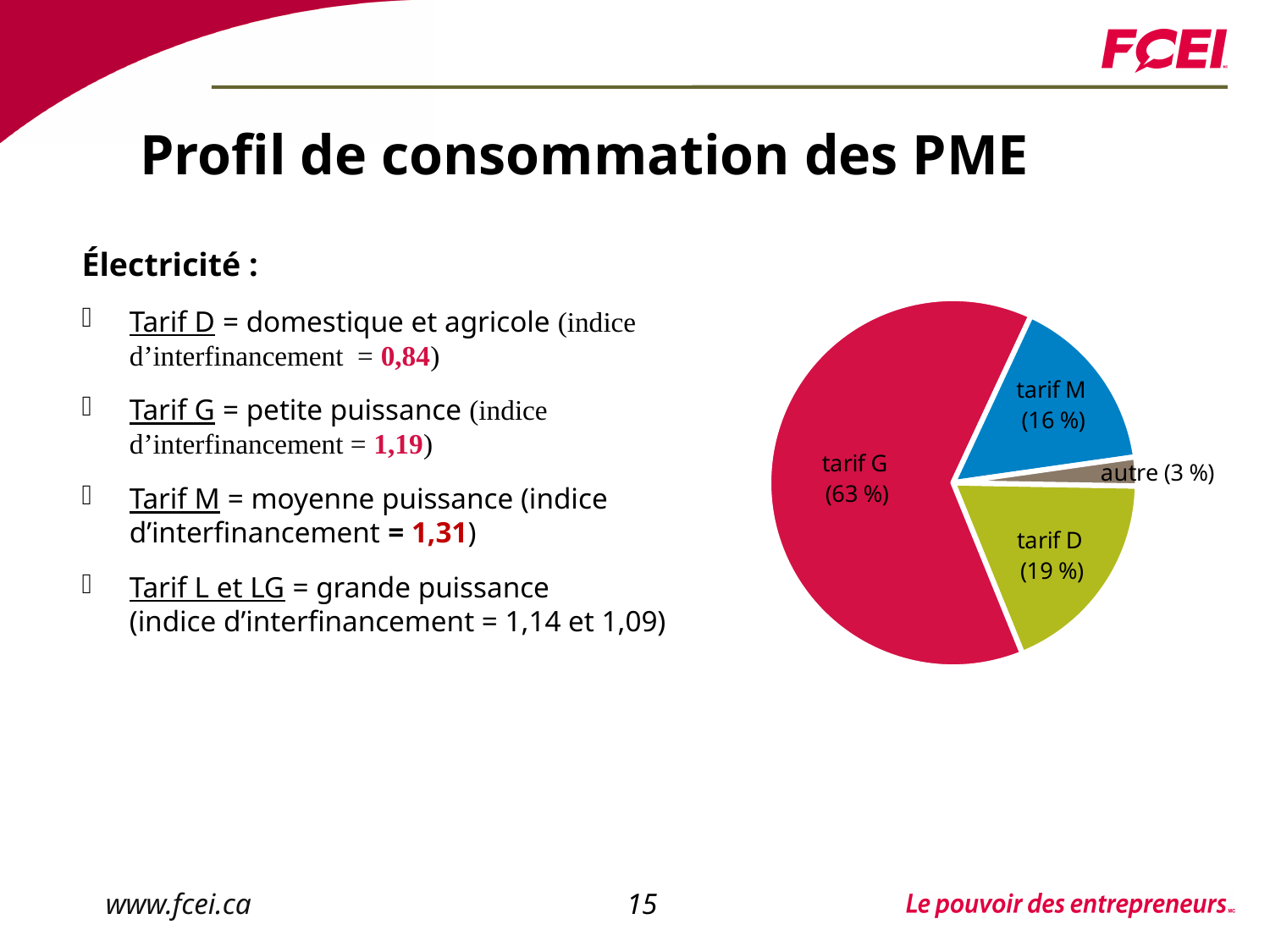
What colour is the tarif M slice of the pie? blue Which slice of the pie is the largest? tarif G What share of the pie does tarif D represent? 19 % What is the difference in percentage points between tarif G and tarif D? 44 What is the difference in percentage points between tarif D and tarif M? 3 What share of the pie does tarif M represent? 16 % Which slice of the pie is the smallest? autre What kind of chart is shown on the slide? pie chart What share of the pie does tarif G represent? 63 % Which is larger, the share for tarif D or the share for tarif M? tarif D How many slices does the pie chart have? 4